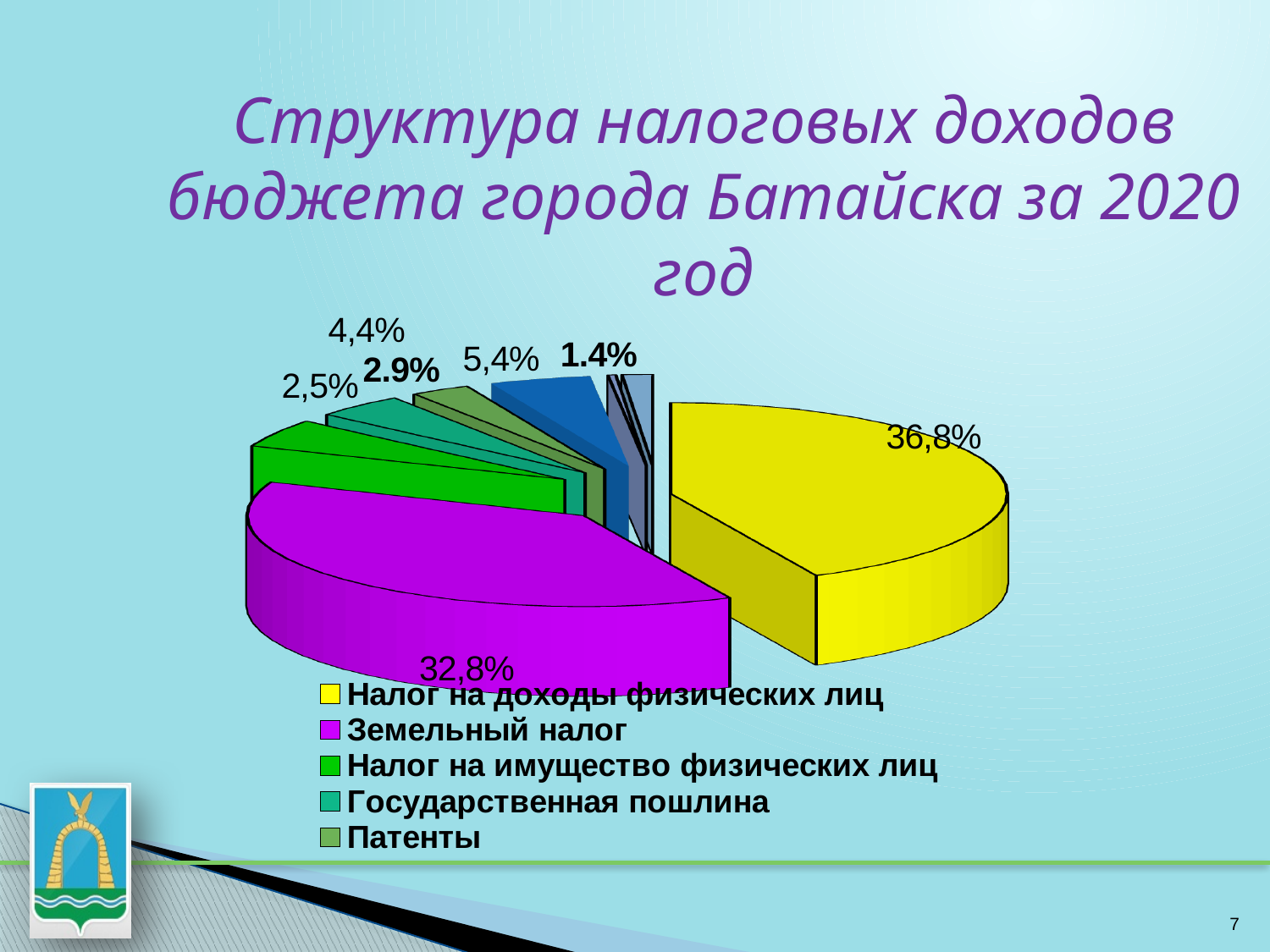
Which is larger: the share of 'Земельный налог' or the share of 'Налог на доходы физических лиц'? Налог на доходы физических лиц What share is shown for 'Земельный налог'? 32,8% Which legend category has the largest slice of the pie? Налог на доходы физических лиц How many categories are listed in the chart legend? 5 What is the difference between the shares of 'Налог на доходы физических лиц' and 'Земельный налог'? 4,0% What colour is the slice for 'Земельный налог'? purple What kind of chart is shown on the slide? pie chart What share of tax revenues does 'Налог на доходы физических лиц' account for? 36,8%